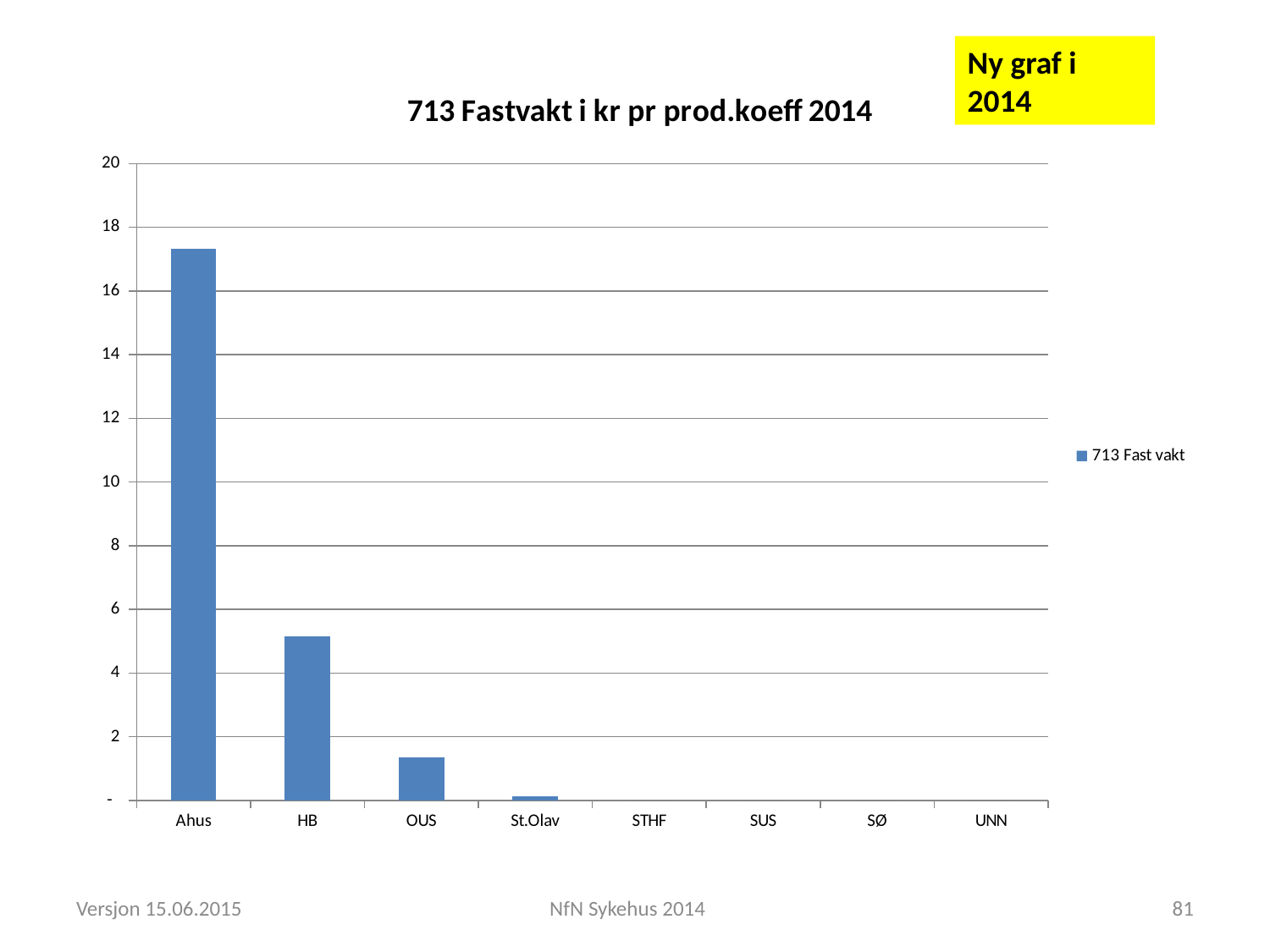
Is the value for Ahus greater or less than 16? greater What is the name of the series listed in the legend? 713 Fast vakt Is the value for HB greater or less than 6? less How many categories are shown on the x axis of the chart? 8 Which is larger, the value for HB or the value for OUS? HB Is the value for HB greater or less than 4? greater How many series does the legend list? 1 Which is larger, the value for Ahus or the value for HB? Ahus Which category has the highest value in the chart? Ahus What kind of chart is shown on the slide? bar chart What is the title of the chart? 713 Fastvakt i kr pr prod.koeff 2014